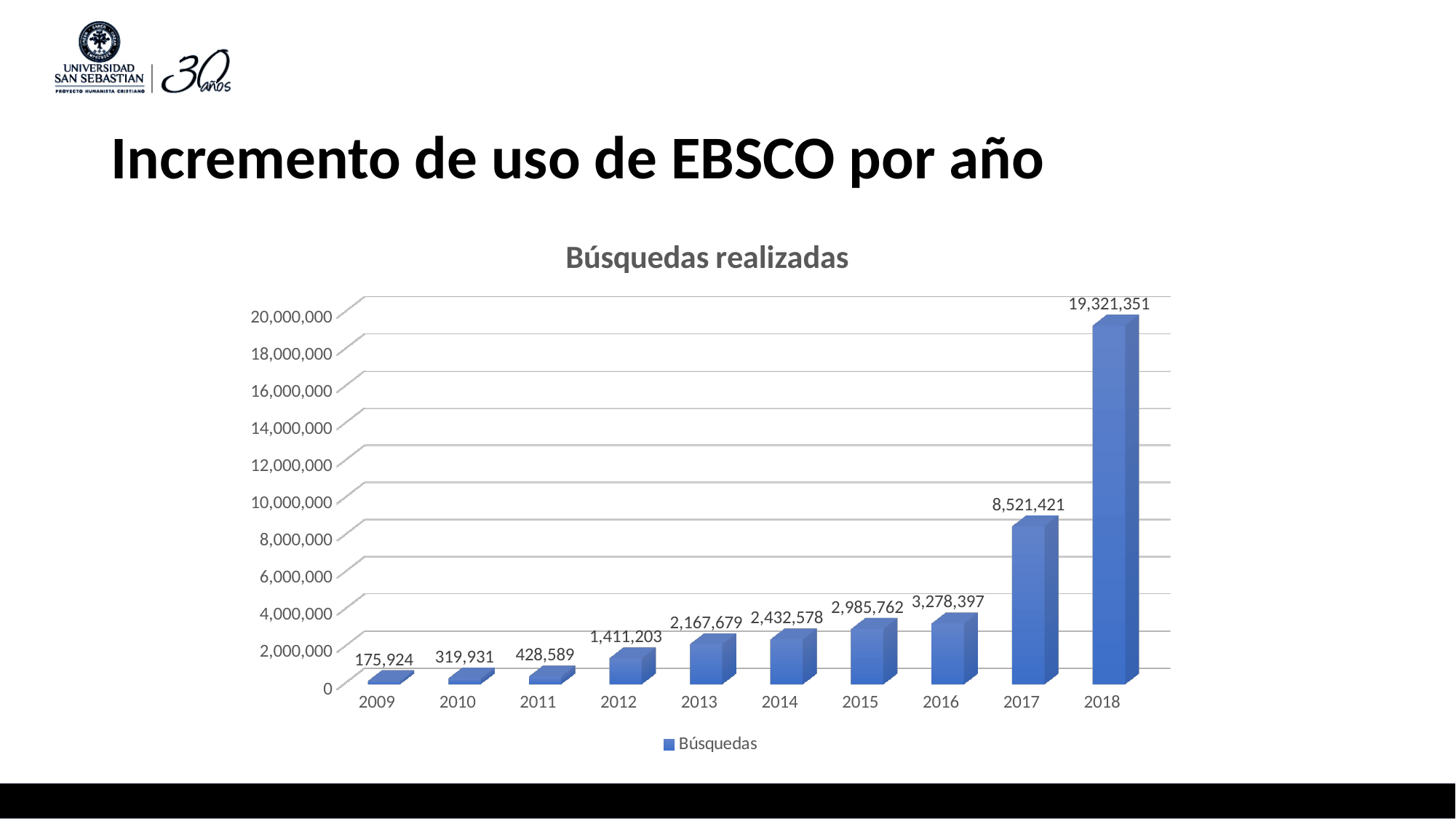
What is the value for 2018? 19,321,351 Which year has the highest number of searches? 2018 Which year has the lowest number of searches? 2009 What kind of chart is shown? bar chart What is the difference between the values for 2016 and 2015? 292,635 Which is larger, the value for 2014 or the value for 2013? 2014 Is the value for 2018 greater or less than 18,000,000? greater Do the values rise or fall from 2009 to 2018? rise How many years are shown on the x axis? 10 What is the value for 2012? 1,411,203 What is the difference between the values for 2018 and 2017? 10,799,930 What is the value for 2009? 175,924